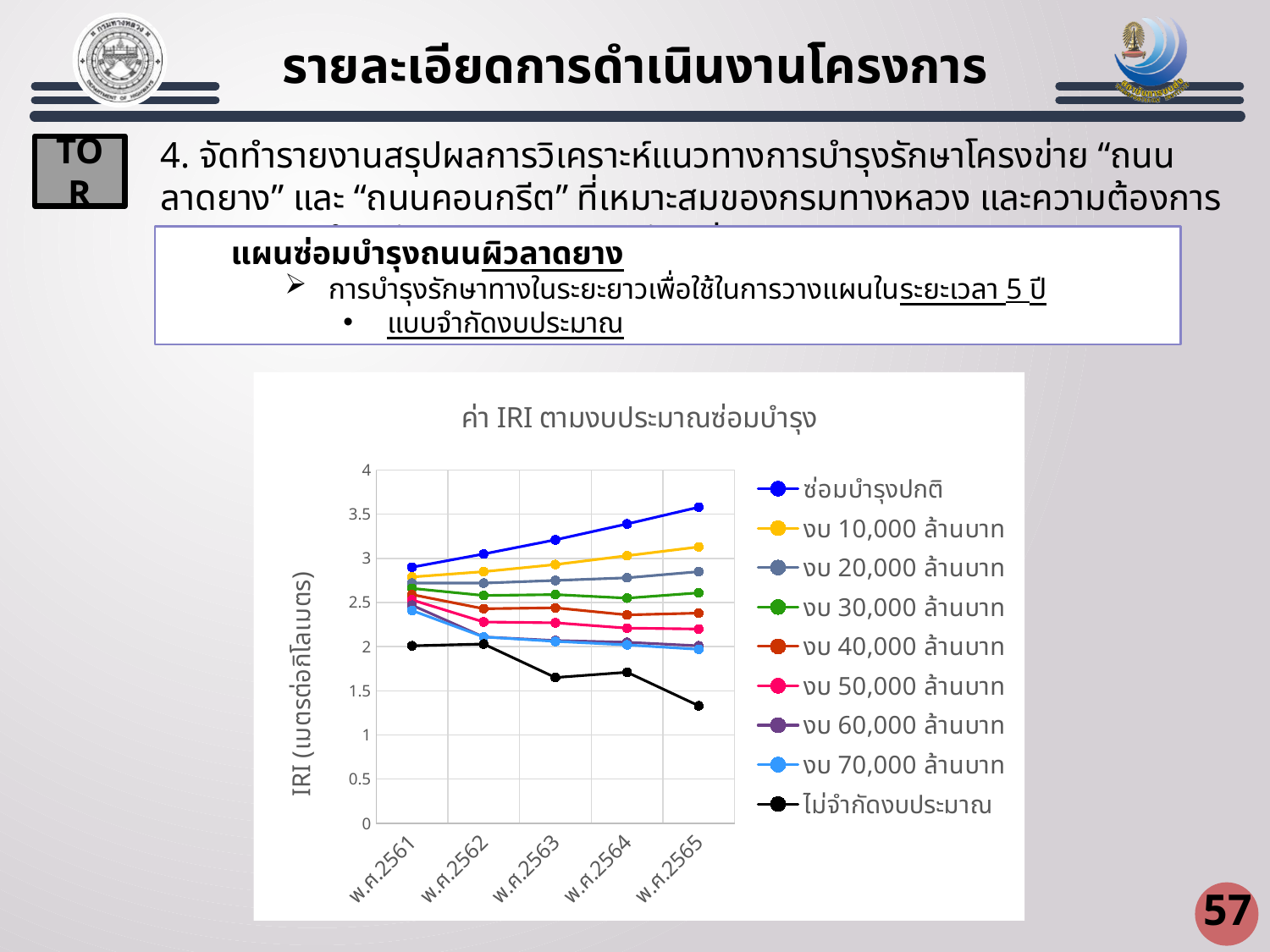
Which series has the highest IRI value at พ.ศ.2565? ซ่อมบำรุงปกติ At พ.ศ.2565, which series has the larger IRI value: งบ 10,000 ล้านบาท or งบ 20,000 ล้านบาท? งบ 10,000 ล้านบาท Is the IRI value for ซ่อมบำรุงปกติ at พ.ศ.2565 greater or less than 3? greater What kind of chart is shown on the slide? line chart What is the label of the vertical axis of the chart? IRI (เมตรต่อกิโลเมตร) How many years are plotted along the x axis of the chart? 5 How many series does the legend of the chart list? 9 Is the IRI value for ไม่จำกัดงบประมาณ at พ.ศ.2565 greater or less than 1.5? less Which series has the lowest IRI value at พ.ศ.2565? ไม่จำกัดงบประมาณ What is the title of the chart? ค่า IRI ตามงบประมาณซ่อมบำรุง Does the ไม่จำกัดงบประมาณ series rise or fall overall from พ.ศ.2561 to พ.ศ.2565? fall Does the ซ่อมบำรุงปกติ series rise or fall from พ.ศ.2561 to พ.ศ.2565? rise